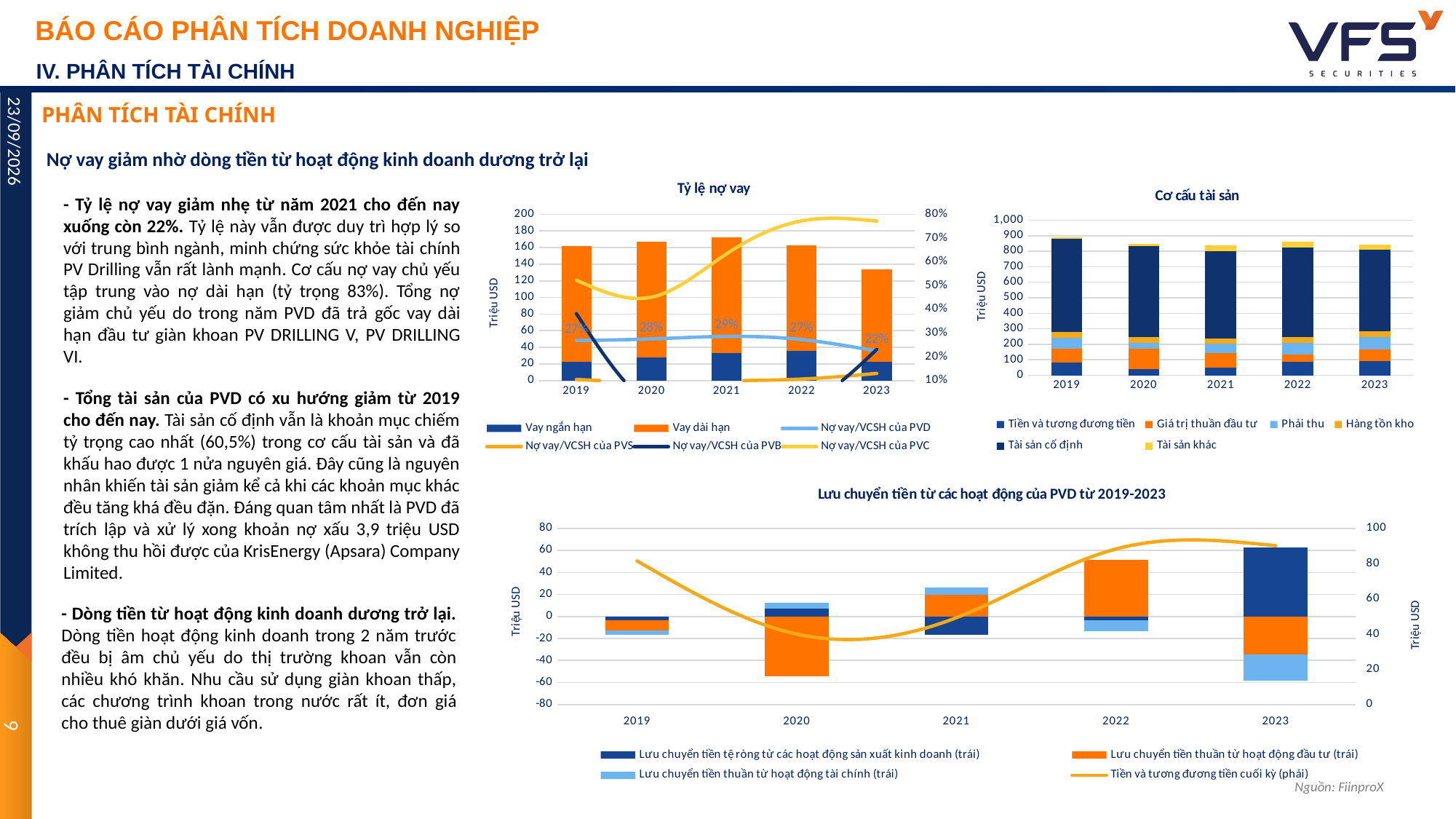
In the 'Tỷ lệ nợ vay' chart, what is the value of Nợ vay/VCSH của PVD in 2021? 29% In the 'Tỷ lệ nợ vay' chart, in which year is Nợ vay/VCSH của PVD lowest? 2023 In the 'Tỷ lệ nợ vay' chart, is Nợ vay/VCSH của PVD higher in 2020 or in 2022? 2020 In the 'Tỷ lệ nợ vay' chart, what is the difference between Nợ vay/VCSH của PVD in 2021 and in 2023? 7 percentage points In the 'Tỷ lệ nợ vay' chart, in which year is Nợ vay/VCSH của PVD highest? 2021 In the 'Tỷ lệ nợ vay' chart, is the total height of the stacked bar for 2023 greater or less than 140? less In the 'Tỷ lệ nợ vay' chart, what is the value of Nợ vay/VCSH của PVD in 2023? 22% In the 'Lưu chuyển tiền từ các hoạt động của PVD từ 2019-2023' chart, how many series does the legend list? 4 In the 'Cơ cấu tài sản' chart, how many years are shown on the x axis? 5 In the 'Cơ cấu tài sản' chart, is the total height of the stacked bar for 2019 greater or less than 800? greater In the 'Cơ cấu tài sản' chart, how many series does the legend list? 6 In the 'Tỷ lệ nợ vay' chart, how many series does the legend list? 6